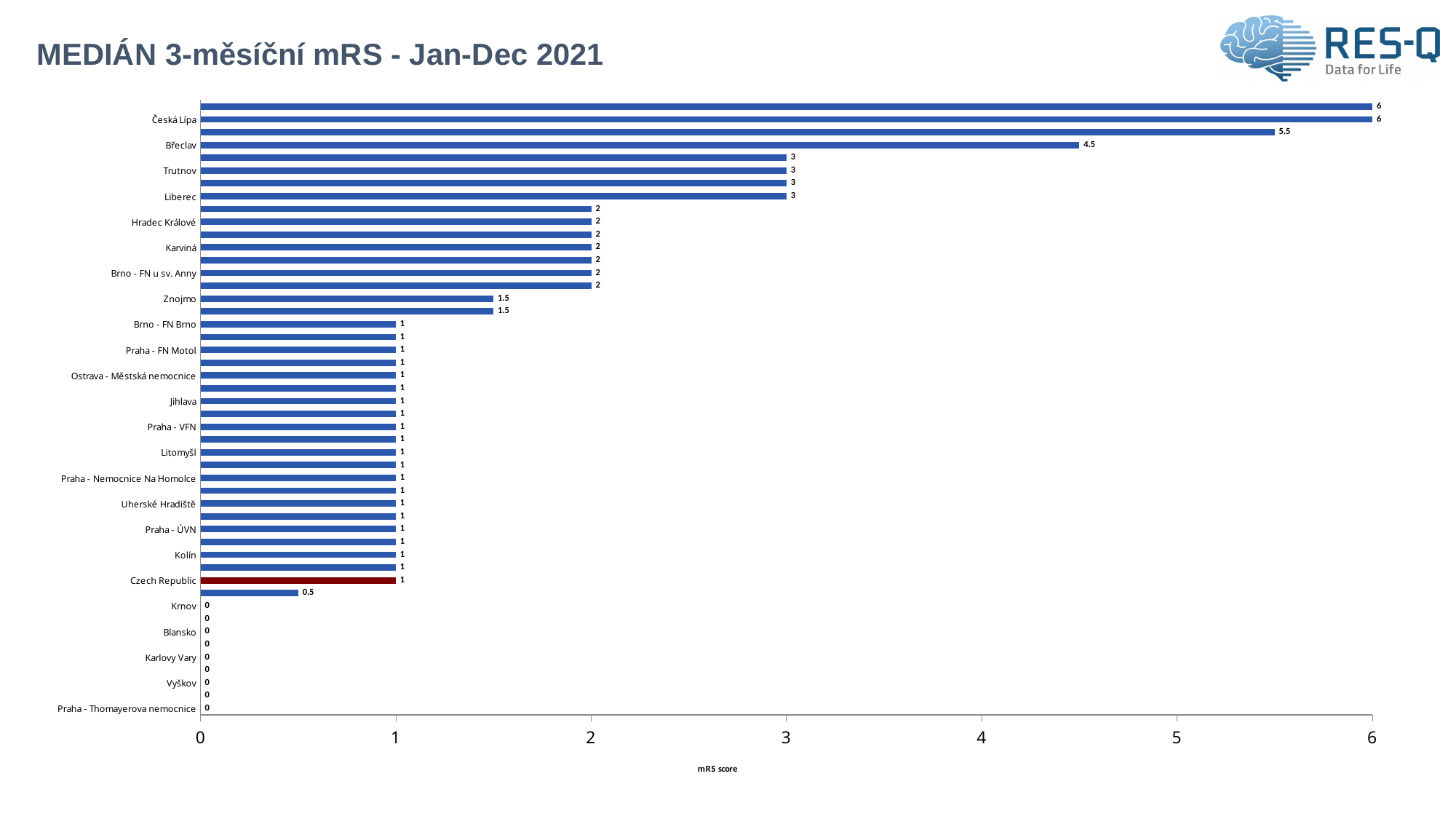
Which has a larger value, Břeclav or Liberec? Břeclav Which category's bar is coloured dark red instead of blue? Czech Republic What is the value shown for Krnov? 0 Is the value for Břeclav greater or less than 4? greater What is the value shown for Břeclav? 4.5 What is the difference between the values for Česká Lípa and Břeclav? 1.5 What is the value shown for Czech Republic? 1 What kind of chart is shown on the slide? Bar chart Which has a larger value, Hradec Králové or Jihlava? Hradec Králové What is the value shown for Znojmo? 1.5 What is the value shown for Trutnov? 3 What is the median 3-month mRS value for Česká Lípa? 6